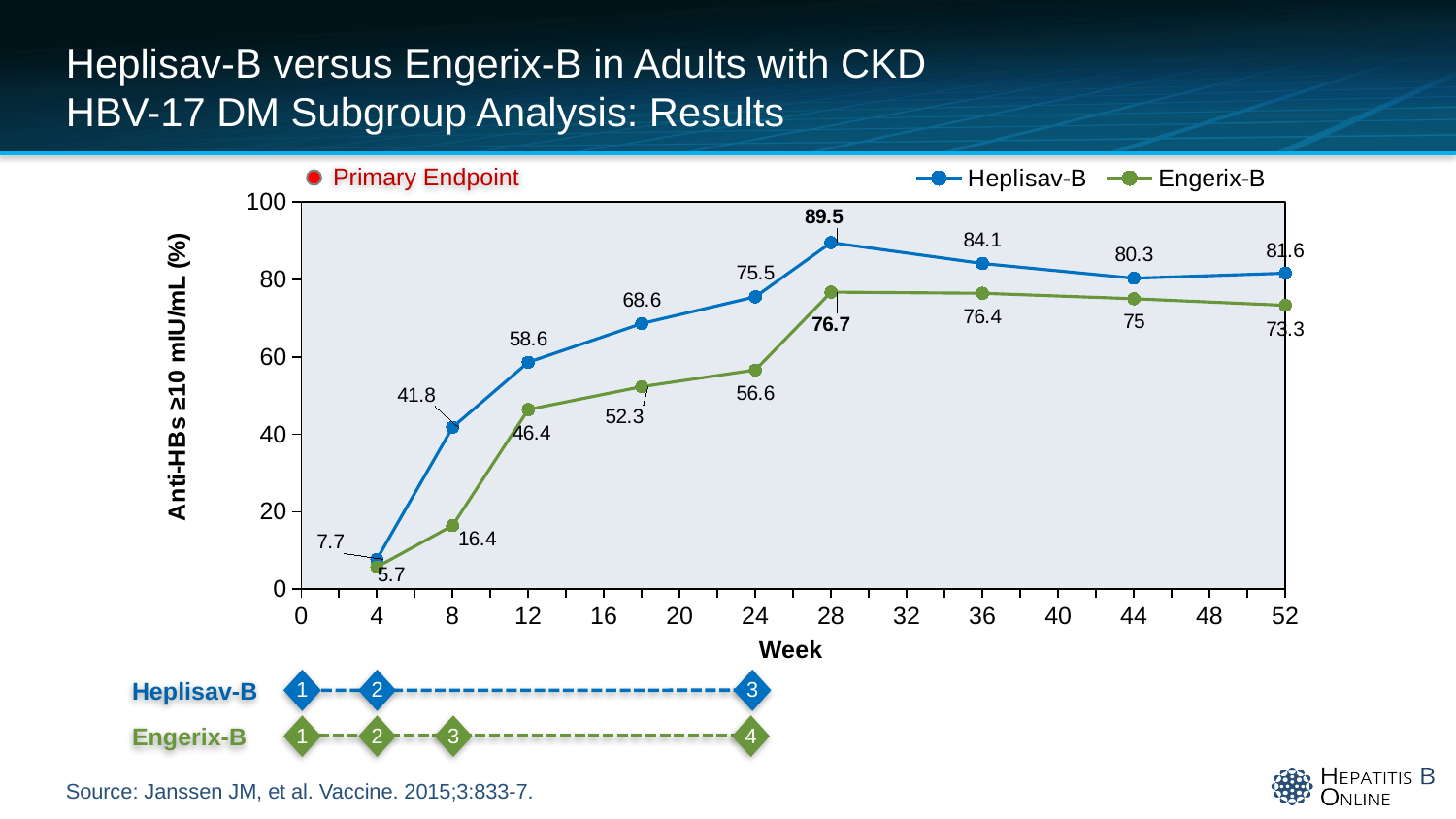
How many series does the legend list? 2 What is the Engerix-B value at week 12? 46.4 What is the difference between the Heplisav-B and Engerix-B values at week 28? 12.8 What is the Engerix-B value at week 52? 73.3 How many data points are plotted for the Heplisav-B series? 9 What is the lowest value plotted for Engerix-B? 5.7 Is the Engerix-B value at week 44 greater or less than 60? greater Does the Heplisav-B line rise or fall between week 4 and week 28? Rise What is the Heplisav-B value at week 28? 89.5 What type of chart is shown on the slide? Line chart Which series has the higher value at week 8, Heplisav-B or Engerix-B? Heplisav-B At which week does Heplisav-B reach its highest value? Week 28